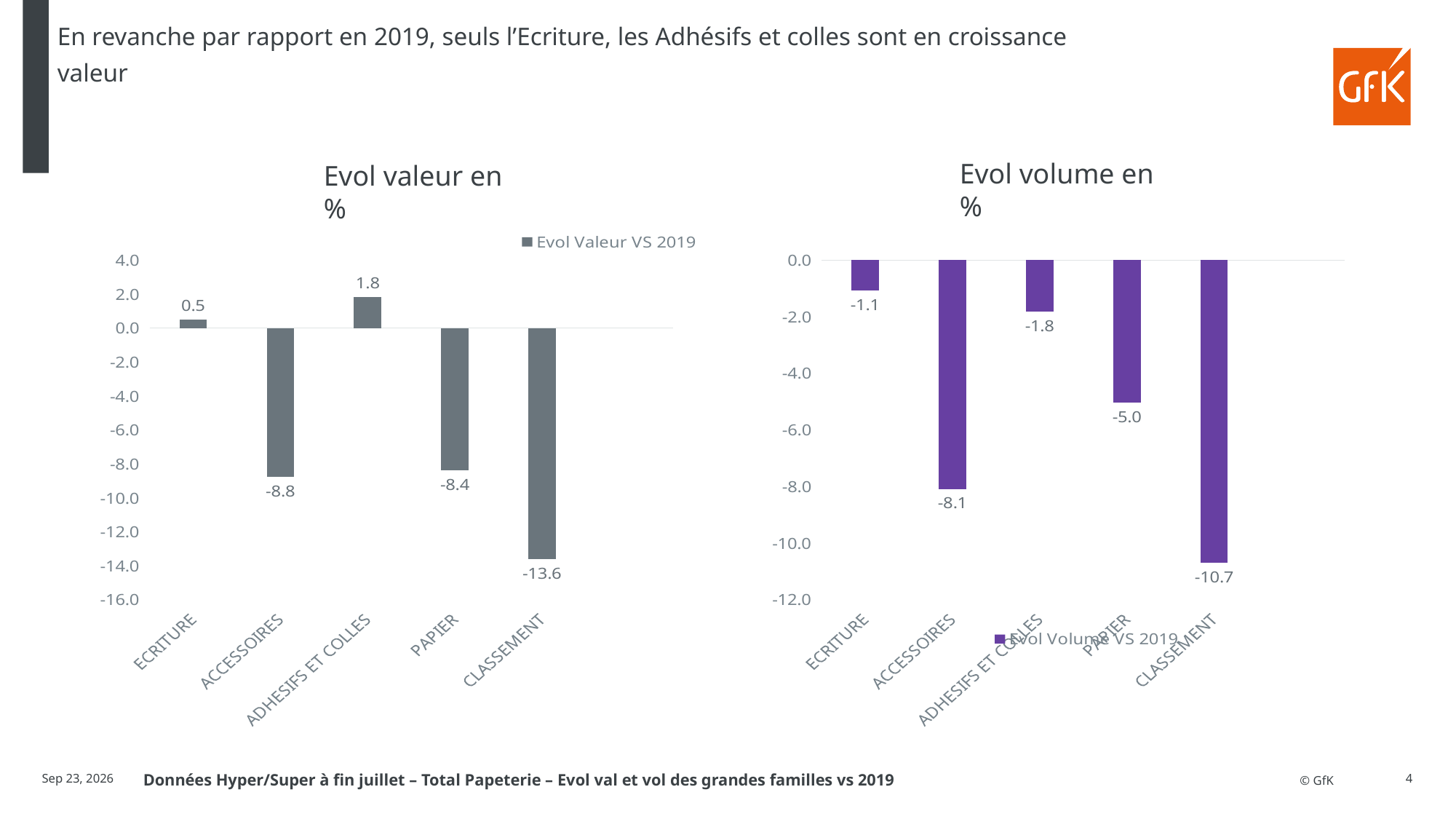
In the 'Evol volume en %' chart, what is the value for PAPIER? -5.0 What is the legend entry of the 'Evol valeur en %' chart? Evol Valeur VS 2019 In the 'Evol volume en %' chart, what is the value for ECRITURE? -1.1 In the 'Evol volume en %' chart, which category has the lowest value? CLASSEMENT How many categories are shown in the 'Evol volume en %' chart? 5 In the 'Evol valeur en %' chart, what is the value for CLASSEMENT? -13.6 What type of chart is the 'Evol valeur en %' chart? Bar chart In the 'Evol valeur en %' chart, which is larger, the value for ACCESSOIRES or the value for PAPIER? PAPIER In the 'Evol volume en %' chart, what is the difference between the values for ACCESSOIRES and PAPIER? 3.1 In the 'Evol valeur en %' chart, which category has the highest value? ADHESIFS ET COLLES In the 'Evol valeur en %' chart, what is the difference between the values for ADHESIFS ET COLLES and ECRITURE? 1.3 In the 'Evol valeur en %' chart, what is the value for ADHESIFS ET COLLES? 1.8